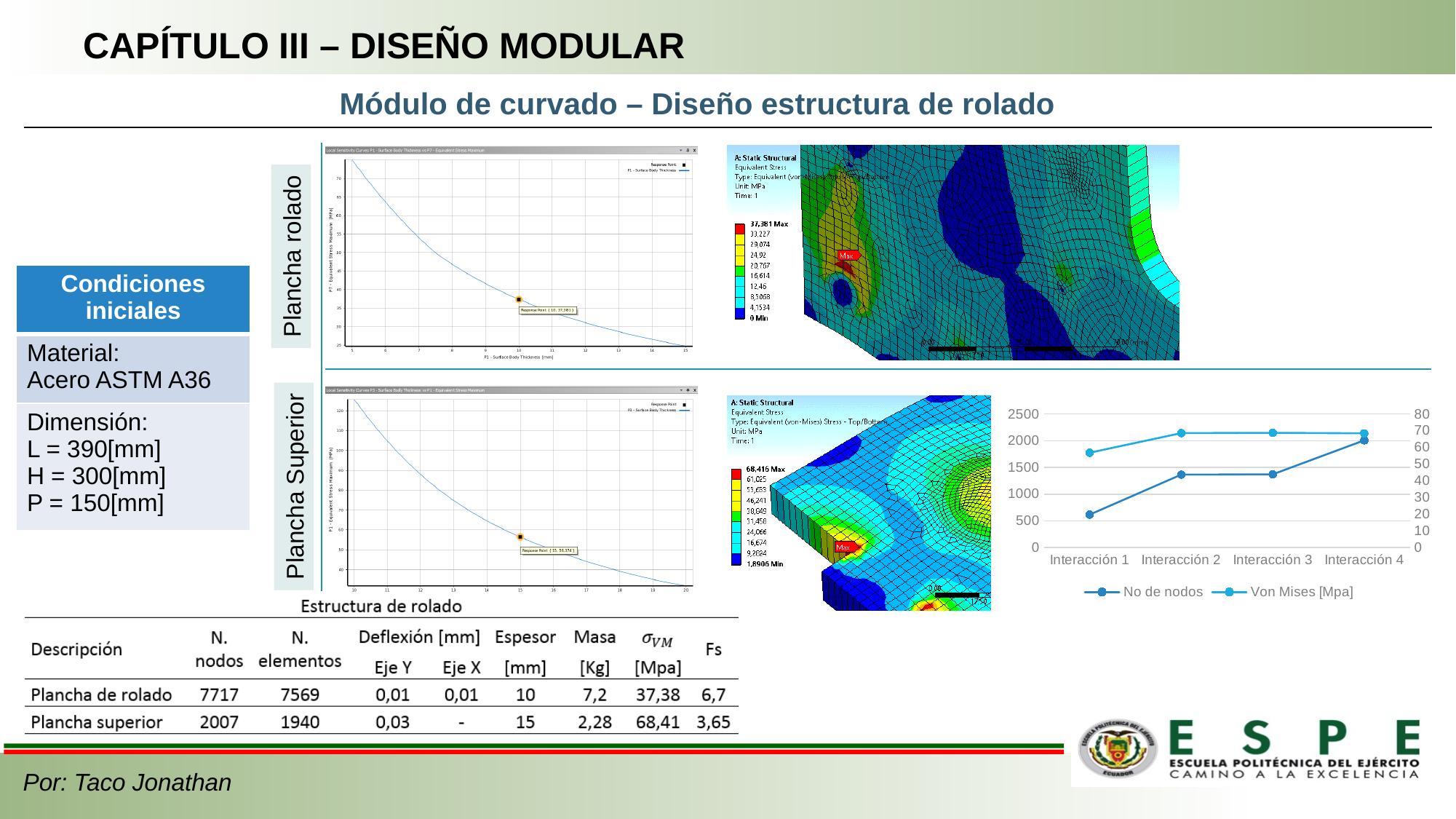
In the bottom-right line chart, which interaction has the lowest value for No de nodos? Interacción 1 How many series does the legend of the bottom-right line chart list? 2 In the bottom-right line chart, is the value of No de nodos for Interacción 4 greater or less than 1500? greater How many categories are shown on the x axis of the bottom-right line chart? 4 In the bottom-right line chart, is the Von Mises [Mpa] value for Interacción 1 greater or less than 50 on the right axis? greater In the bottom-right line chart, which interaction has the lowest value for Von Mises [Mpa]? Interacción 1 In the bottom-right line chart, does the No de nodos series generally rise or fall from Interacción 1 to Interacción 4? Rise In the bottom-right line chart, which interaction has the highest value for No de nodos? Interacción 4 In the bottom-right line chart, which is larger for No de nodos: Interacción 1 or Interacción 2? Interacción 2 What kind of chart is the chart at the bottom right of the slide? Line chart In the bottom-right line chart, is the value of No de nodos for Interacción 1 greater or less than 1000? less What are the two legend entries of the bottom-right line chart? No de nodos and Von Mises [Mpa]